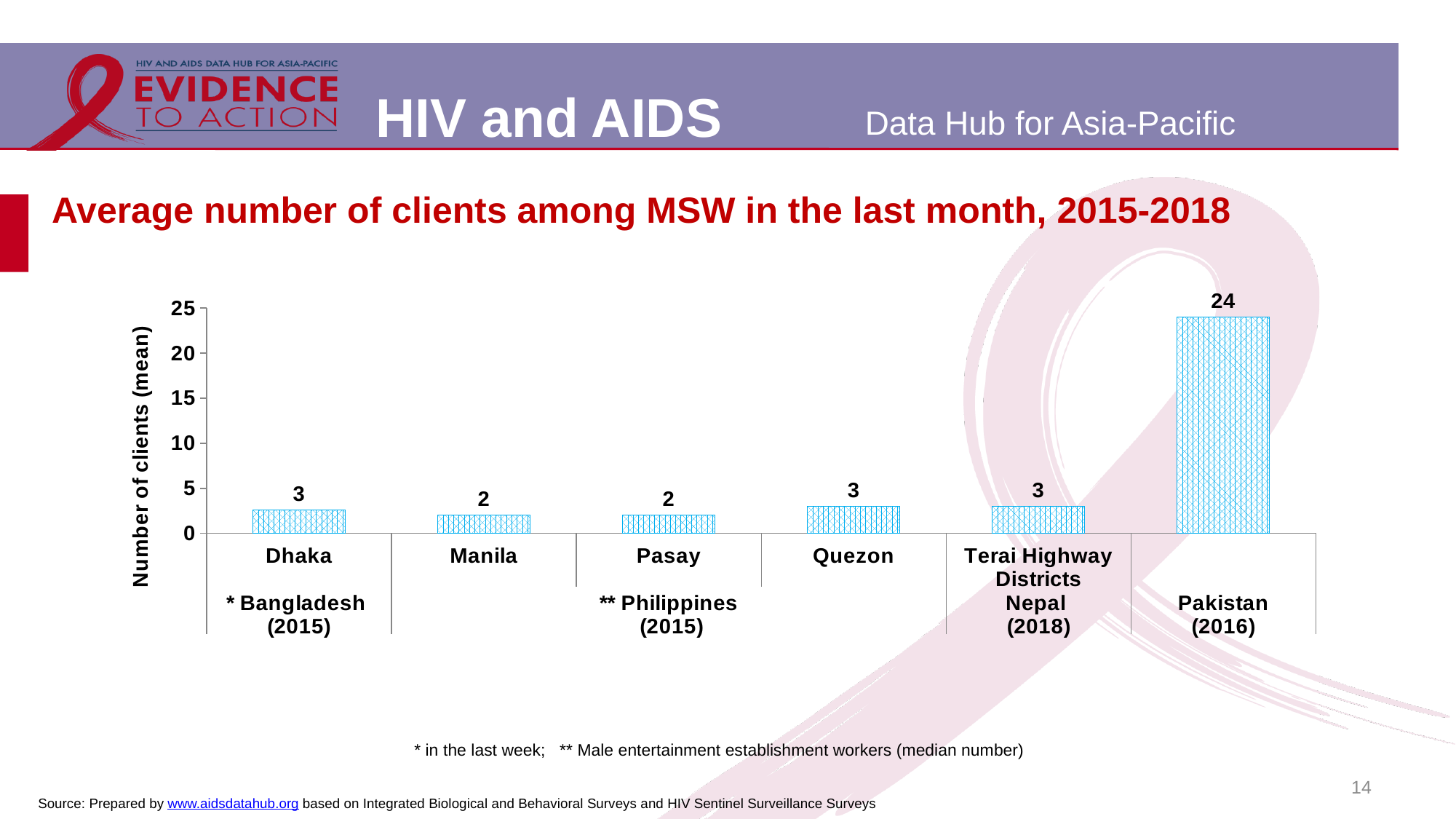
What is the title of the chart? Average number of clients among MSW in the last month, 2015-2018 What is the difference between the values for Pakistan and Quezon? 21 What is the value shown for Terai Highway Districts, Nepal? 3 What is the label of the vertical axis? Number of clients (mean) What is the average number of clients for Dhaka? 3 What is the average number of clients for Pakistan? 24 What is the average number of clients for Manila? 2 What kind of chart is shown on the slide? bar chart Which is larger, the value for Pasay or the value for Quezon? Quezon Is the value for Pakistan greater or less than 20? greater Which category has the highest average number of clients? Pakistan How many categories (bars) are shown in the chart? 6